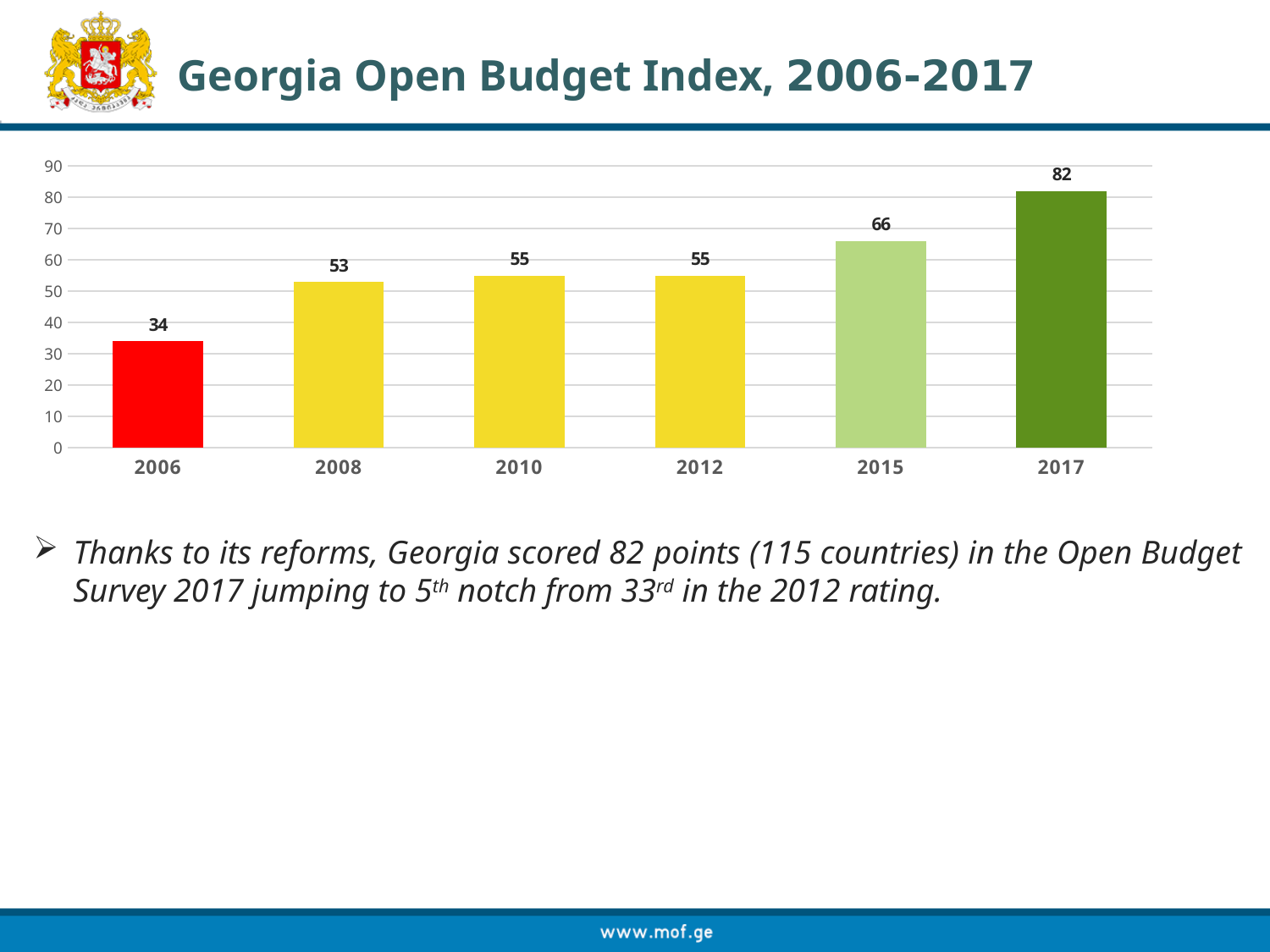
What is the Open Budget Index value for 2008? 53 Which is larger, the value for 2015 or the value for 2010? 2015 Which year has the highest Open Budget Index value? 2017 What is the Open Budget Index value for 2015? 66 What is the Open Budget Index value for 2006? 34 Which year has the lowest Open Budget Index value? 2006 What kind of chart is shown on the slide? bar chart What is the difference between the 2017 value and the 2012 value? 27 Is the value for 2017 greater or less than 80? greater How many years are shown on the x axis of the chart? 6 What colour is the bar for 2006? red What is the difference between the 2008 value and the 2006 value? 19